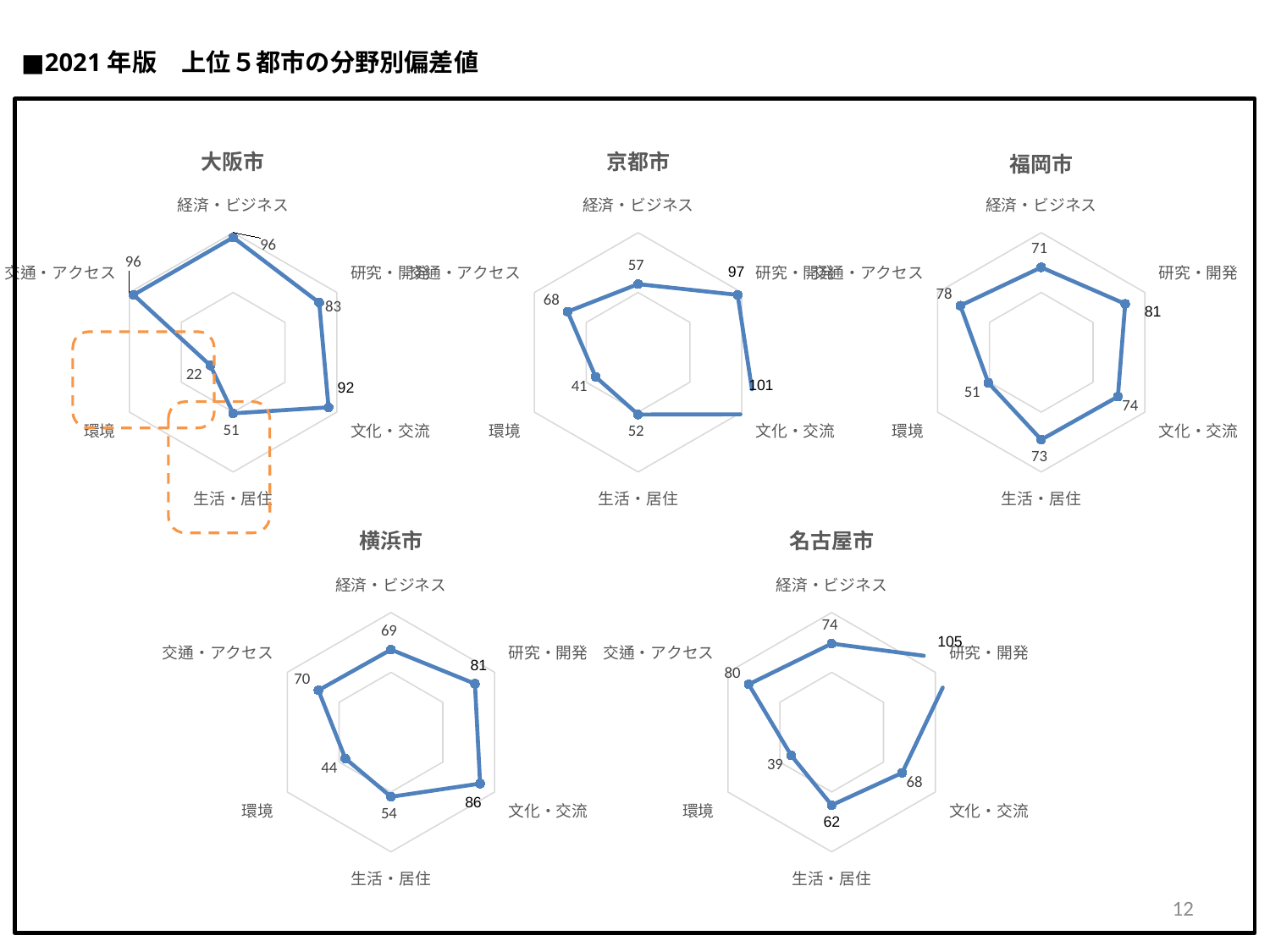
In the 京都市 chart, what is the difference between the values for 研究・開発 and 環境? 56 What kind of chart is used for 名古屋市? Radar chart In the 名古屋市 chart, what is the difference between the values for 交通・アクセス and 環境? 41 In the 福岡市 chart, what is the value for 生活・居住? 73 How many charts are shown on the slide? 5 In the 大阪市 chart, what is the value for 環境? 22 In the 名古屋市 chart, which category has the highest value? 研究・開発 In the 横浜市 chart, which category has the lowest value? 環境 In the 横浜市 chart, what is the value for 文化・交流? 86 How many categories (axes) does the 大阪市 chart have? 6 In the 京都市 chart, what is the value for 文化・交流? 101 In the 福岡市 chart, which is larger, the value for 研究・開発 or the value for 交通・アクセス? 研究・開発